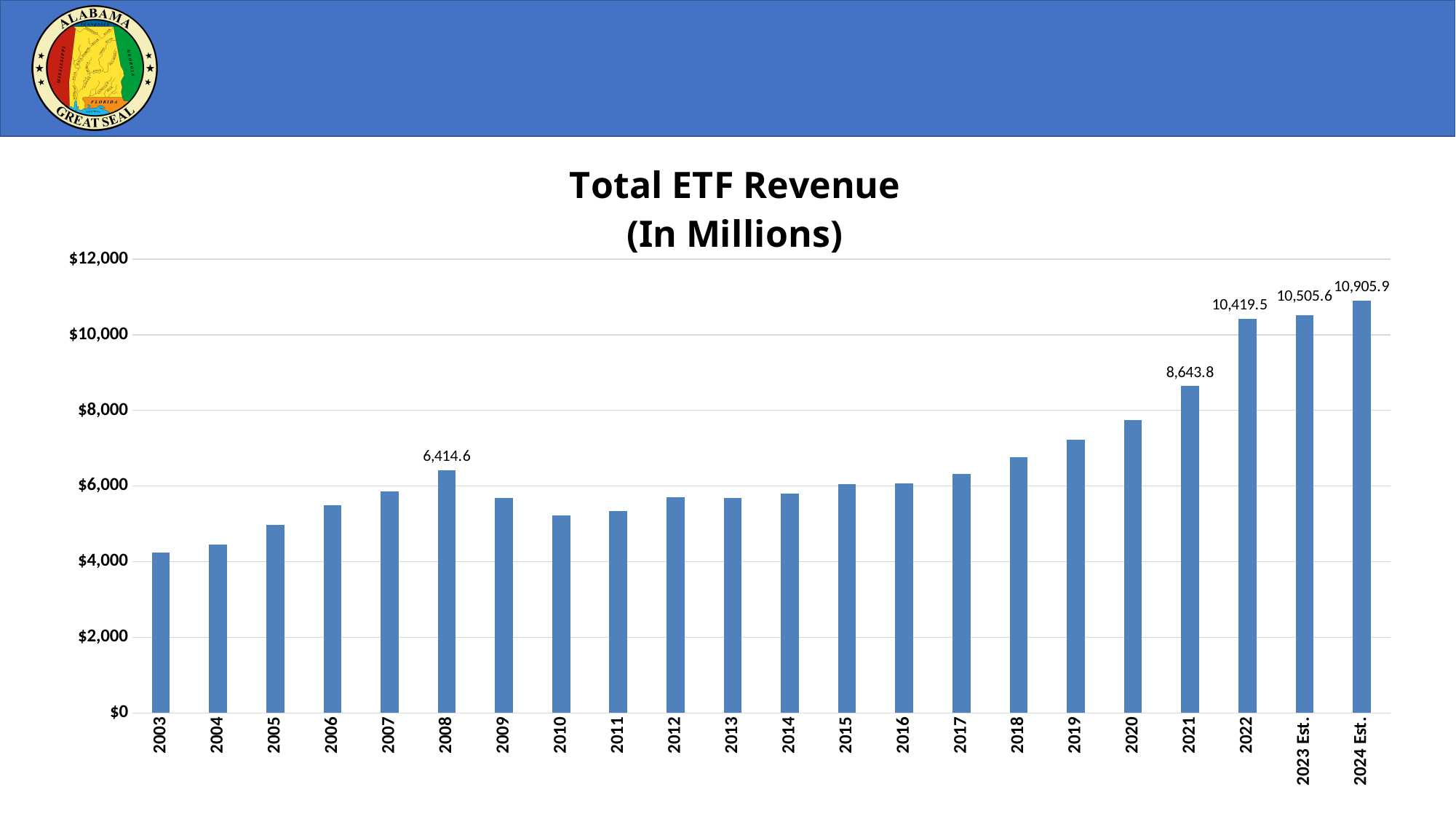
What is the value for 2024 Est.? 10,905.9 Is the value for 2010 greater or less than $6,000? less How many years are shown on the x axis? 22 Which year has the highest Total ETF Revenue? 2024 Est. What is the difference between the values for 2024 Est. and 2023 Est.? 400.3 What is the value for 2008? 6,414.6 Which year has the lowest Total ETF Revenue? 2003 Is the value for 2020 greater or less than $6,000? greater What is the value for 2021? 8,643.8 What kind of chart is shown on the slide? bar chart What is the difference between the values for 2022 and 2021? 1,775.7 Which is larger, the value for 2008 or the value for 2009? 2008